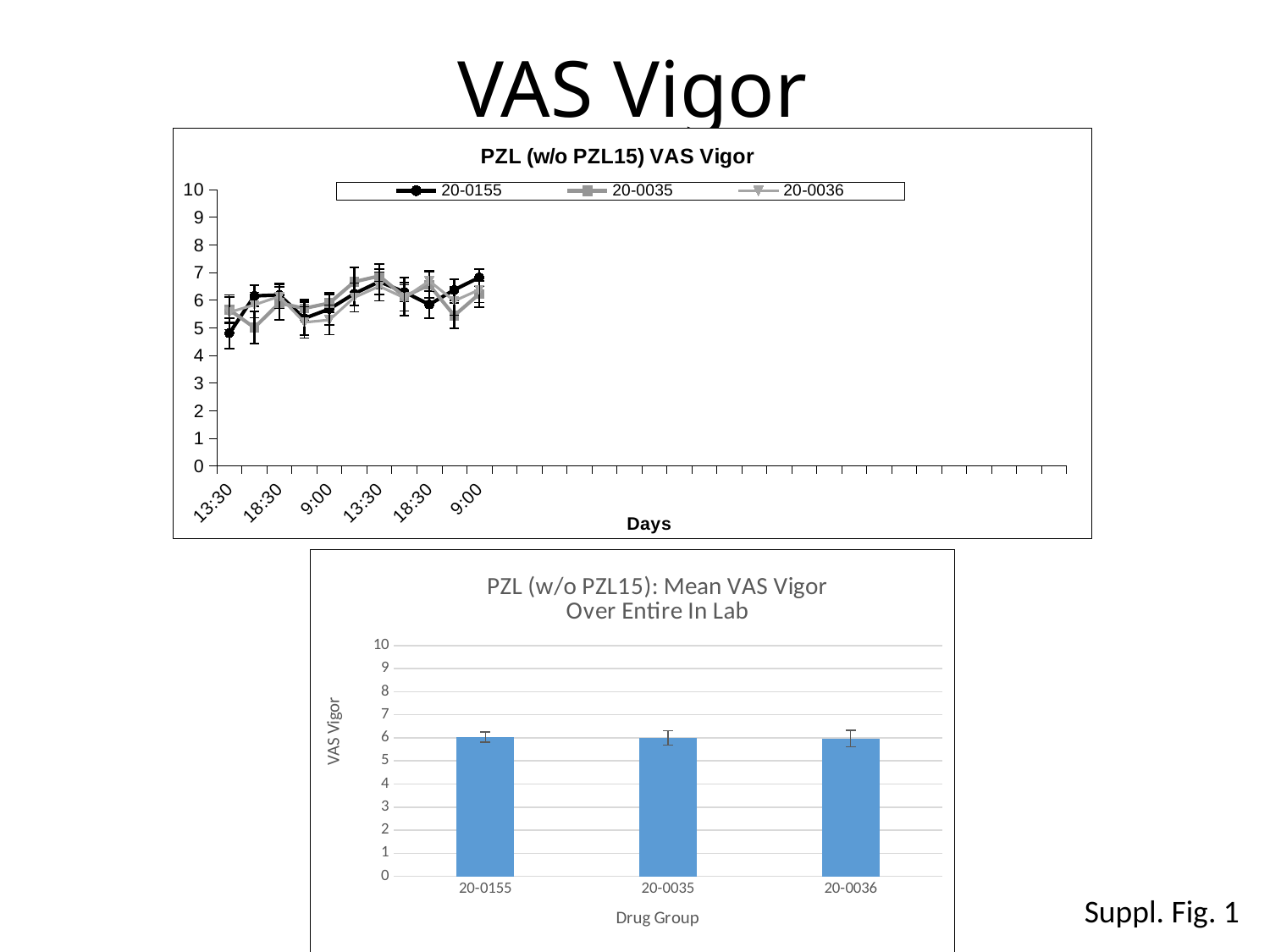
What kind of chart is the bottom chart titled 'PZL (w/o PZL15): Mean VAS Vigor Over Entire In Lab'? bar chart In the bottom chart 'Mean VAS Vigor Over Entire In Lab', is the value for 20-0036 greater or less than 7? less In the bottom chart 'Mean VAS Vigor Over Entire In Lab', how many drug groups are plotted? 3 What kind of chart is the top chart titled 'PZL (w/o PZL15) VAS Vigor'? line chart What is the x-axis title of the bottom chart 'Mean VAS Vigor Over Entire In Lab'? Drug Group In the top chart 'PZL (w/o PZL15) VAS Vigor', what is the maximum value shown on the y-axis? 10 In the bottom chart 'Mean VAS Vigor Over Entire In Lab', is the value for 20-0035 greater or less than 4? greater In the top chart 'PZL (w/o PZL15) VAS Vigor', what are the three series names listed in the legend? 20-0155, 20-0035, 20-0036 In the top chart 'PZL (w/o PZL15) VAS Vigor', is the value for 20-0155 at the last plotted time point greater or less than 8? less In the top chart 'PZL (w/o PZL15) VAS Vigor', how many series does the legend list? 3